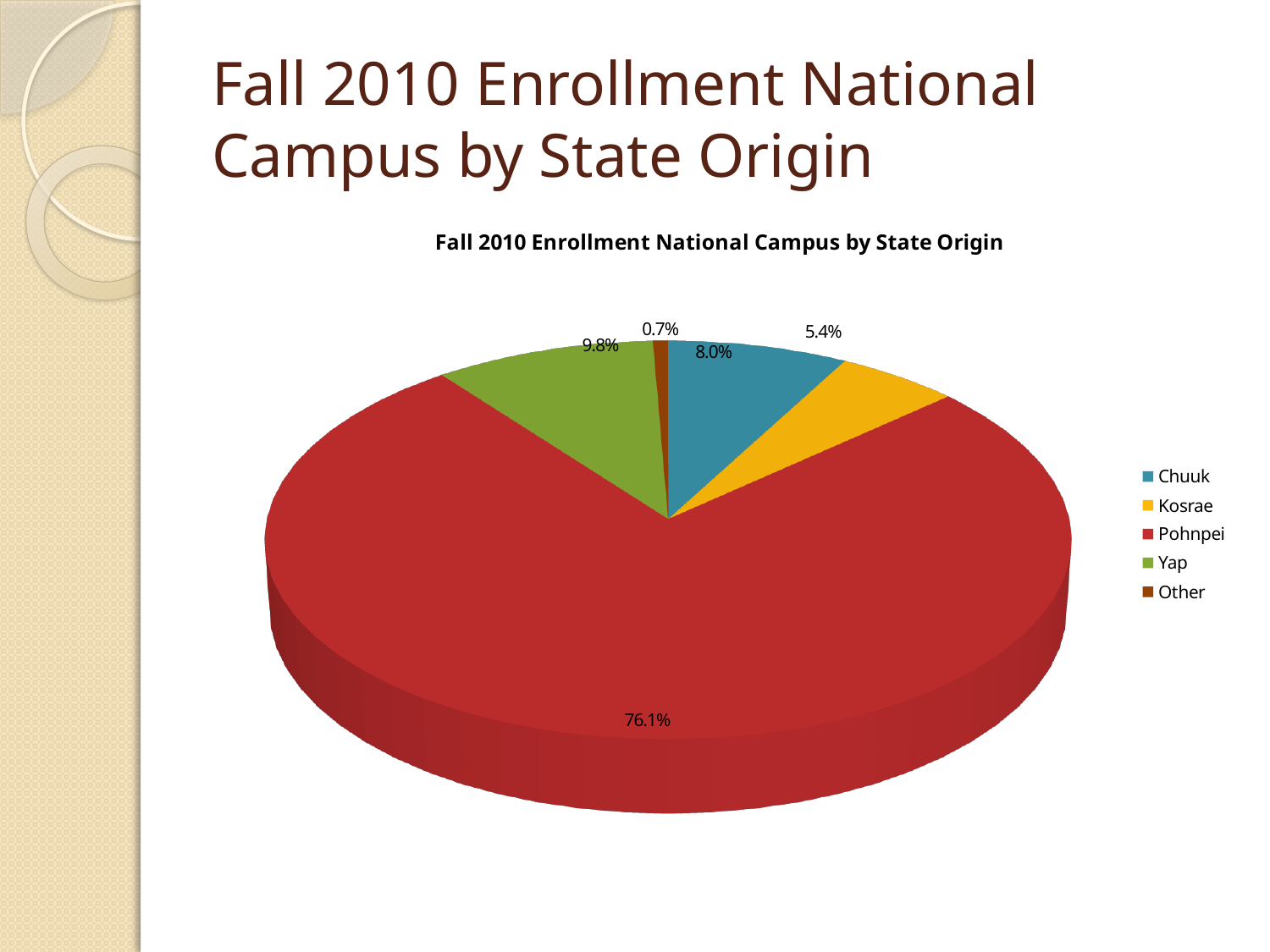
What colour represents Kosrae in the chart? Yellow Which category has the smallest share of enrollment? Other Which state origin has the largest share of enrollment? Pohnpei How many categories does the pie chart show? 5 What share of enrollment came from Kosrae? 5.4% What type of chart is shown on the slide? Pie chart What share of enrollment came from Yap? 9.8% Which has a larger share of enrollment, Yap or Chuuk? Yap What share of enrollment is labelled Other? 0.7% What share of Fall 2010 National Campus enrollment came from Pohnpei? 76.1% What share of enrollment came from Chuuk? 8.0% What is the difference in percentage points between the Yap and Kosrae shares? 4.4